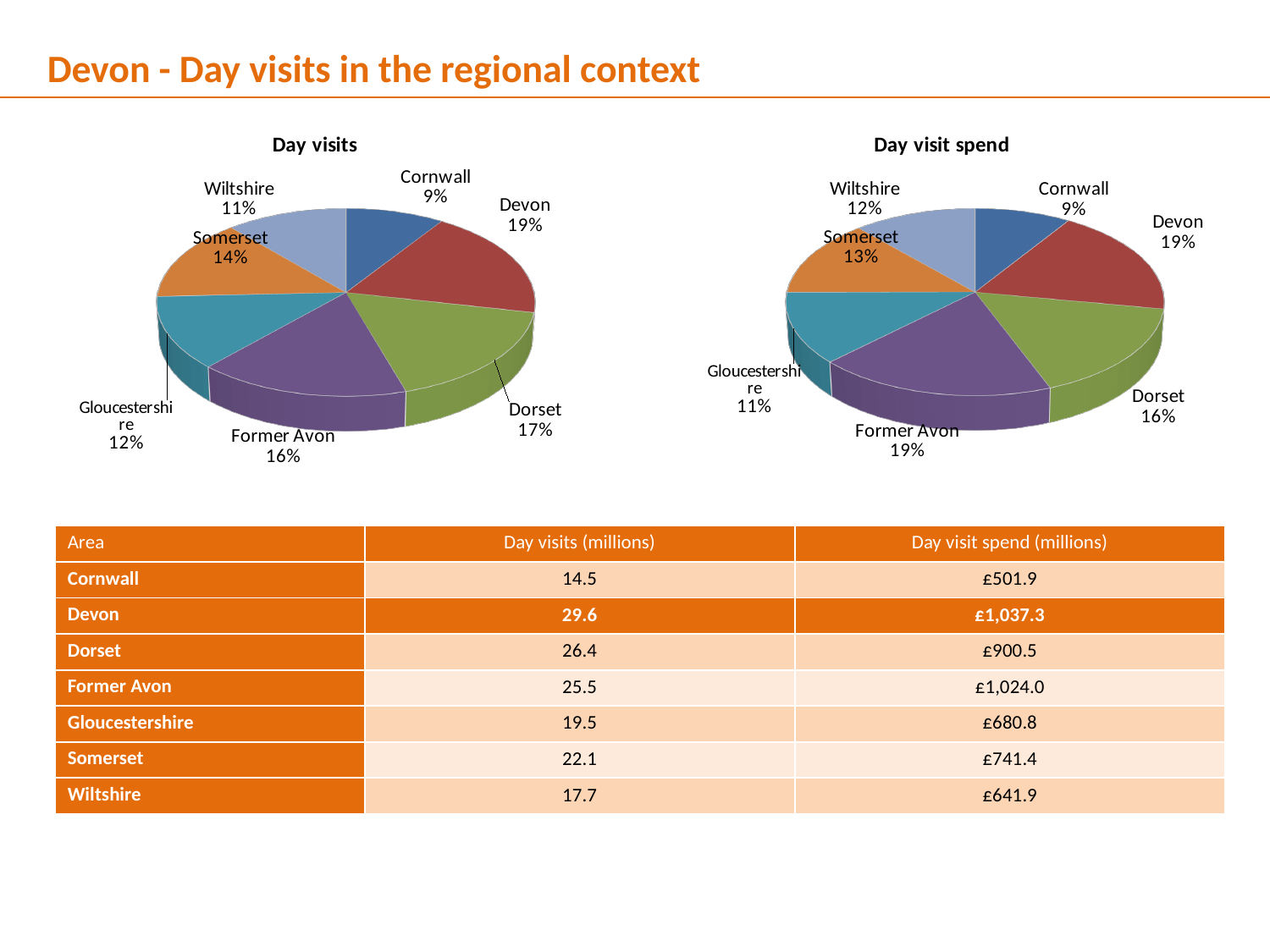
In the "Day visits" chart, which area has the largest share? Devon How many areas are shown in the "Day visits" chart? 7 In the "Day visits" chart, what percentage is shown for Somerset? 14% In the "Day visit spend" chart, which is larger, the share for Somerset or the share for Gloucestershire? Somerset In the "Day visits" chart, which area has the smallest share? Cornwall What kind of chart is the "Day visit spend" chart? Pie chart In the "Day visits" chart, what is the difference in percentage points between Devon and Cornwall? 10 In the "Day visit spend" chart, what percentage is shown for Former Avon? 19% In the "Day visit spend" chart, which area has the smallest share? Cornwall In the "Day visits" chart, what share of day visits does Devon account for? 19% In the "Day visit spend" chart, what share does Dorset account for? 16% What is the title of the chart on the left of the slide? Day visits